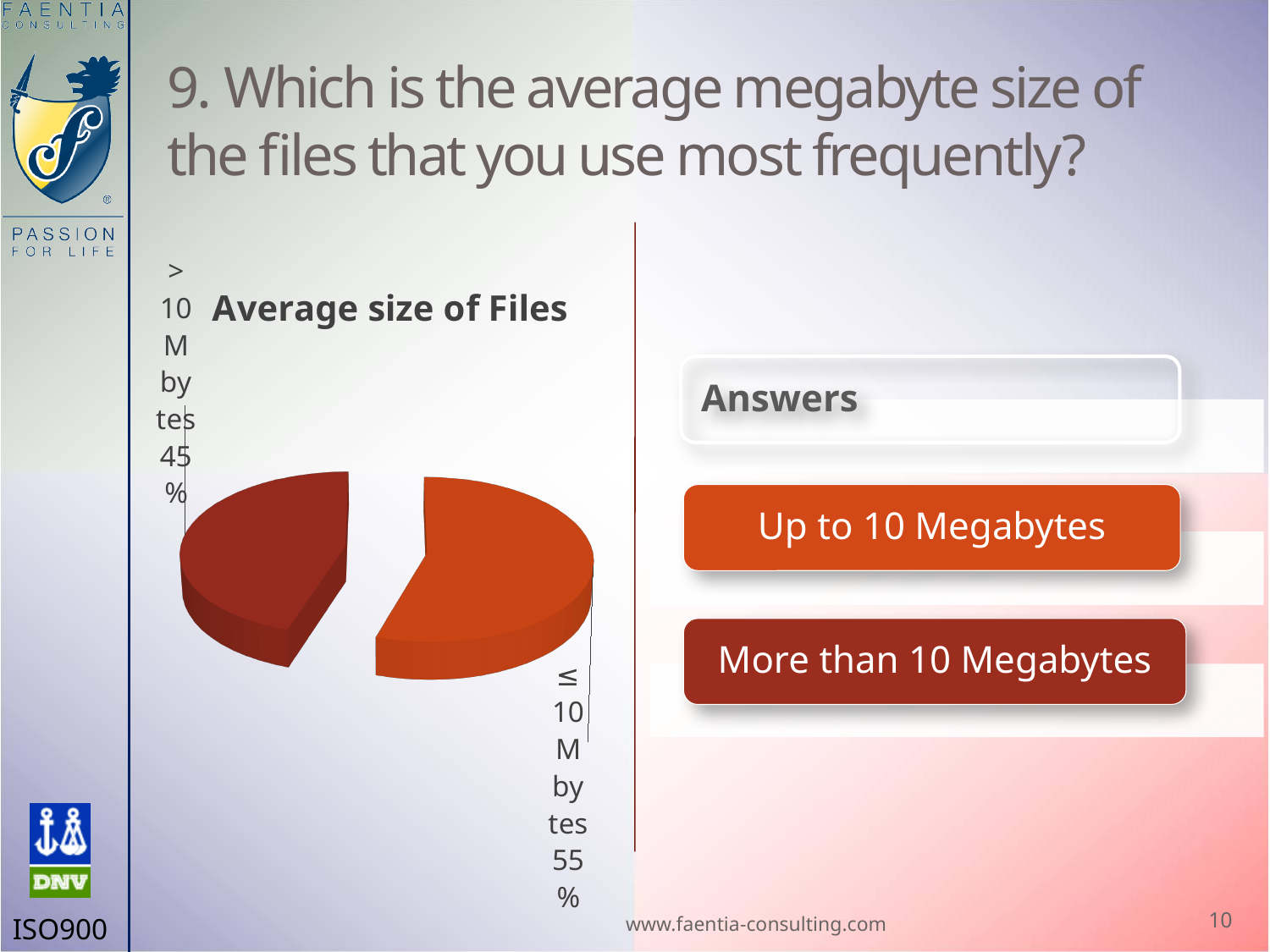
What percentage of the pie is labelled "> 10 Mbytes"? 45% Is the value for "≤ 10 Mbytes" greater or less than 50%? greater What percentage of the pie is labelled "≤ 10 Mbytes"? 55% What is the title of the pie chart on the slide? Average size of Files Is the value for "> 10 Mbytes" greater or less than 50%? less How many slices does the "Average size of Files" pie chart have? 2 What is the difference in percentage points between the "≤ 10 Mbytes" slice and the "> 10 Mbytes" slice? 10 What share of the pie does the "> 10 Mbytes" slice represent? 45% What kind of chart is shown under the title "Average size of Files"? pie chart Which slice of the pie chart is the smallest? > 10 Mbytes Which slice of the pie chart is the largest? ≤ 10 Mbytes Which is larger in the pie chart: the "≤ 10 Mbytes" slice or the "> 10 Mbytes" slice? ≤ 10 Mbytes